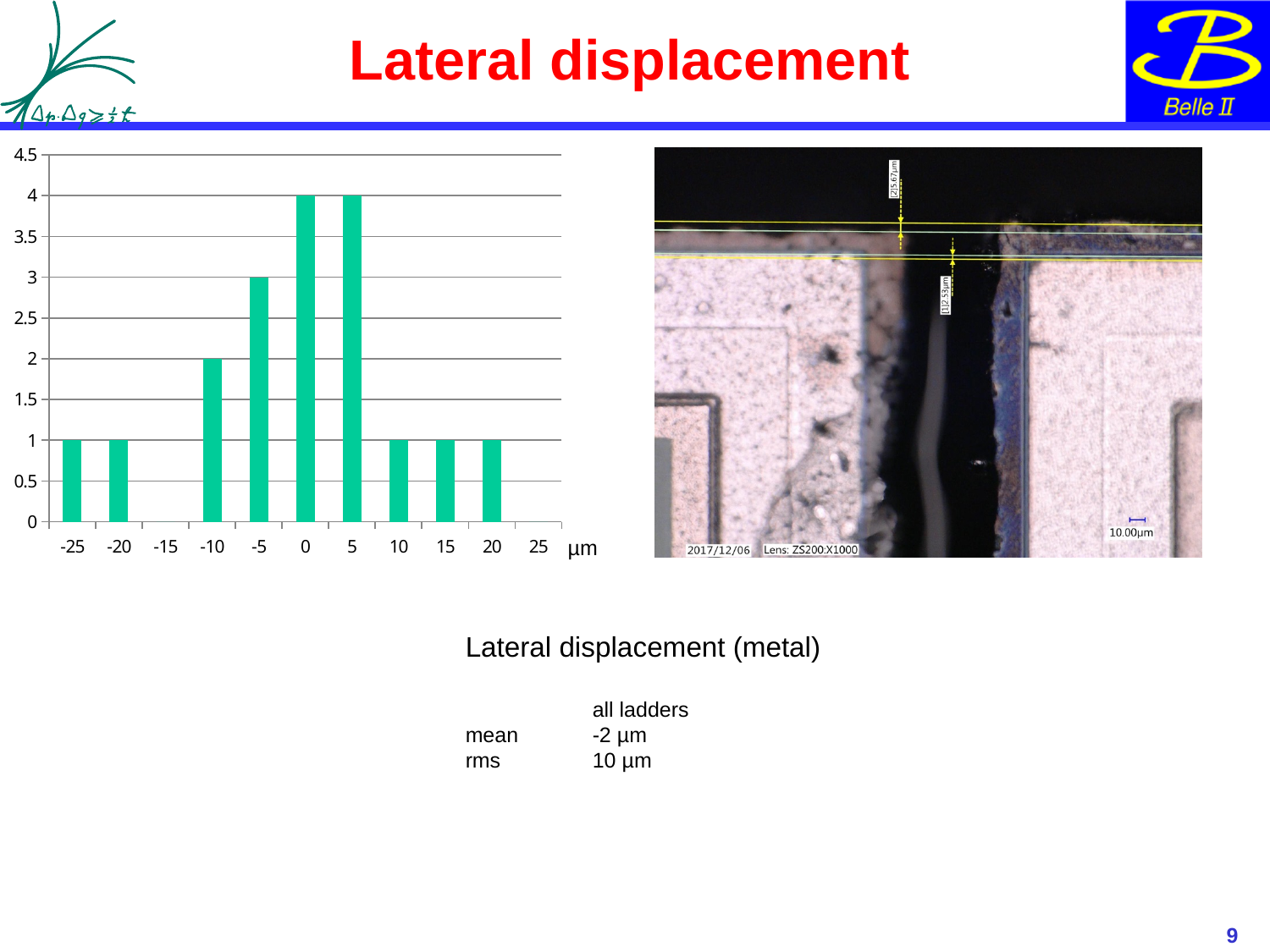
What kind of chart is shown on the left of the slide? bar chart What unit is shown next to the x axis of the bar chart? µm In the bar chart, what is the value for the 20 µm bin? 1 How many bins are labelled on the x axis of the bar chart? 11 What is the maximum value shown on the y axis of the bar chart? 4.5 In the bar chart, which bins have the highest value? 0 and 5 In the bar chart, what is the value for the -10 µm bin? 2 In the bar chart, which is larger, the value for the -5 µm bin or the value for the 10 µm bin? -5 µm bin In the bar chart, what is the value for the -15 µm bin? 0 In the bar chart, what is the value for the -5 µm bin? 3 In the bar chart, what is the difference between the values for the 0 µm bin and the -10 µm bin? 2 In the bar chart, what is the value for the 0 µm bin? 4